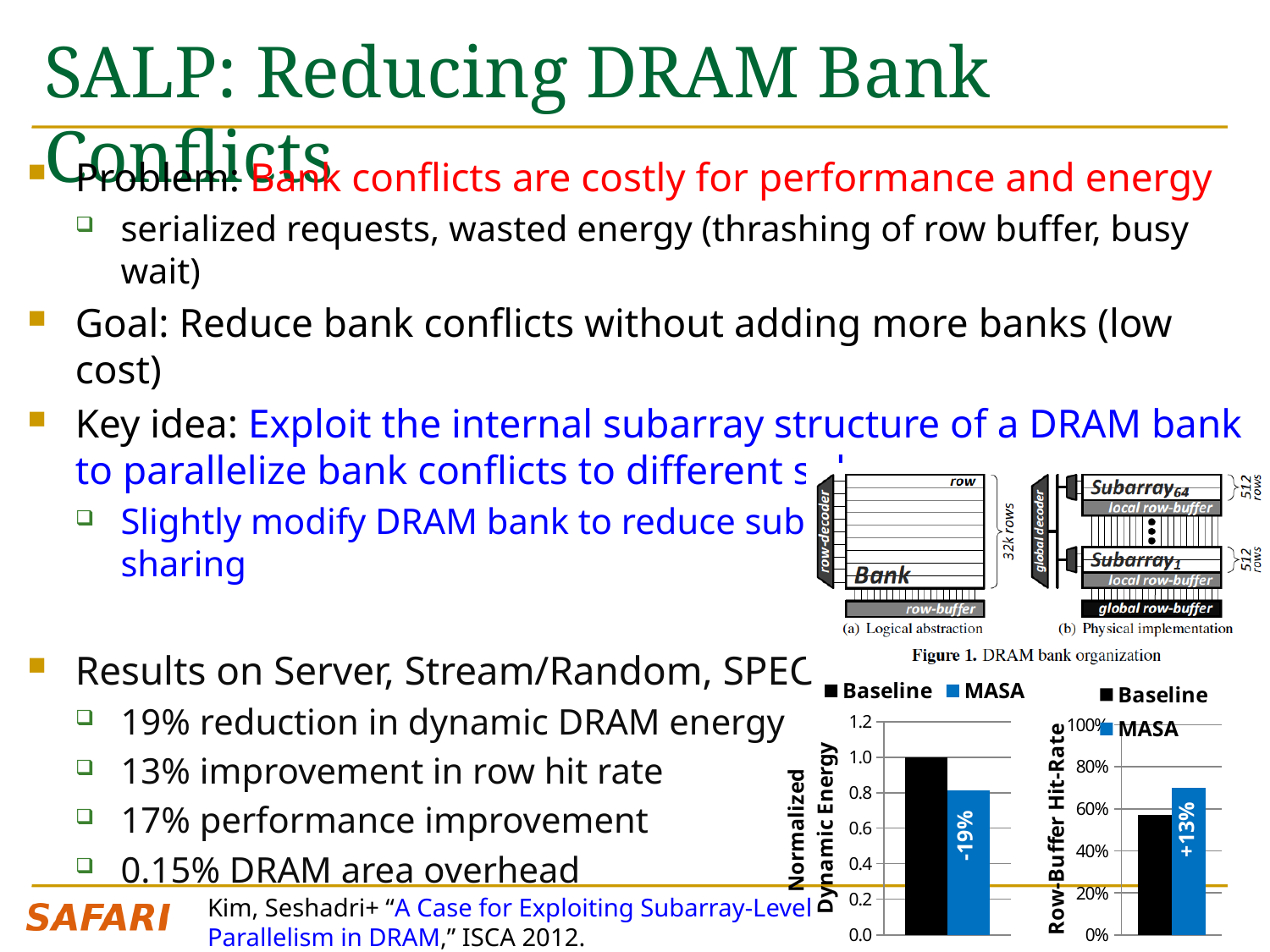
In the Normalized Dynamic Energy chart, which bar is higher, Baseline or MASA? Baseline In the Row-Buffer Hit-Rate chart, is the value for MASA greater or less than 60%? greater What are the two legend entries in the Row-Buffer Hit-Rate chart? Baseline and MASA How many bars are plotted in the Row-Buffer Hit-Rate chart? 2 In the Row-Buffer Hit-Rate chart, what label is printed on the MASA bar? +13% In the Normalized Dynamic Energy chart, what label is printed on the MASA bar? -19% In the Normalized Dynamic Energy chart, what is the value for Baseline? 1.0 In the Row-Buffer Hit-Rate chart, is the value for Baseline greater or less than 40%? greater What kind of chart is the Normalized Dynamic Energy chart? bar chart How many series does the legend of the Normalized Dynamic Energy chart list? 2 In the Row-Buffer Hit-Rate chart, which bar is higher, Baseline or MASA? MASA In the Normalized Dynamic Energy chart, is the value for MASA greater or less than 1.0? less